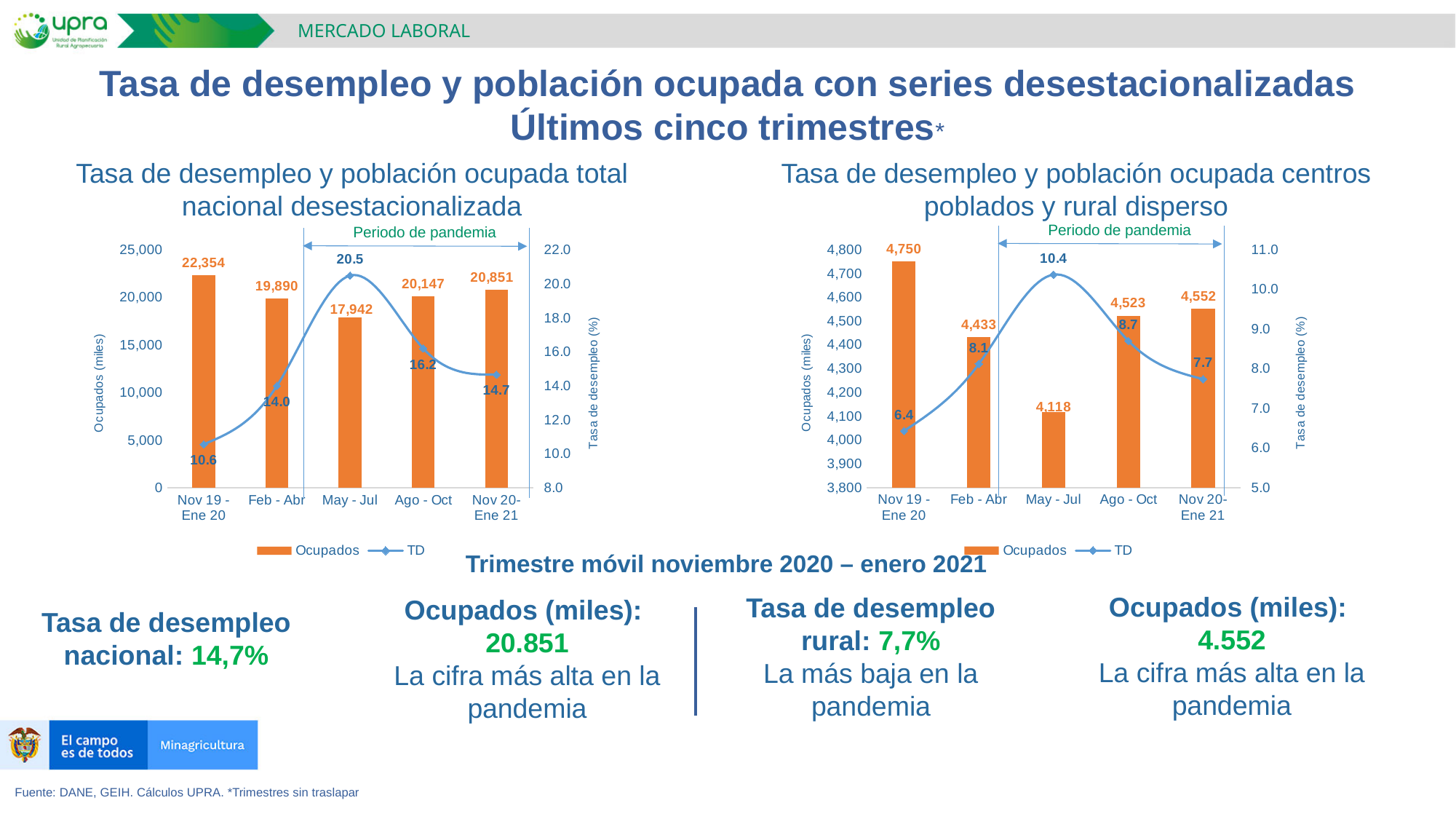
In the right chart (centros poblados y rural disperso), is the Ocupados value for Ago - Oct or Nov 20- Ene 21 larger? Nov 20- Ene 21 How many series does the legend of the right chart (centros poblados y rural disperso) list? 2 In the left chart (total nacional desestacionalizada), which period has the highest TD value? May - Jul In the left chart (total nacional desestacionalizada), what is the Ocupados value for Nov 19 - Ene 20? 22,354 In the right chart (centros poblados y rural disperso), what is the Ocupados value for Feb - Abr? 4,433 How many periods are shown on the x axis of the left chart (total nacional desestacionalizada)? 5 In the left chart (total nacional desestacionalizada), what is the difference in Ocupados between Nov 20- Ene 21 and Ago - Oct? 704 In the right chart (centros poblados y rural disperso), which period has the highest Ocupados value? Nov 19 - Ene 20 In the right chart (centros poblados y rural disperso), what is the TD value for Nov 20- Ene 21? 7.7 In the right chart (centros poblados y rural disperso), what is the difference in TD between May - Jul and Nov 19 - Ene 20? 4.0 In the left chart (total nacional desestacionalizada), which period has the lowest Ocupados value? May - Jul In the left chart (total nacional desestacionalizada), what is the TD value for May - Jul? 20.5